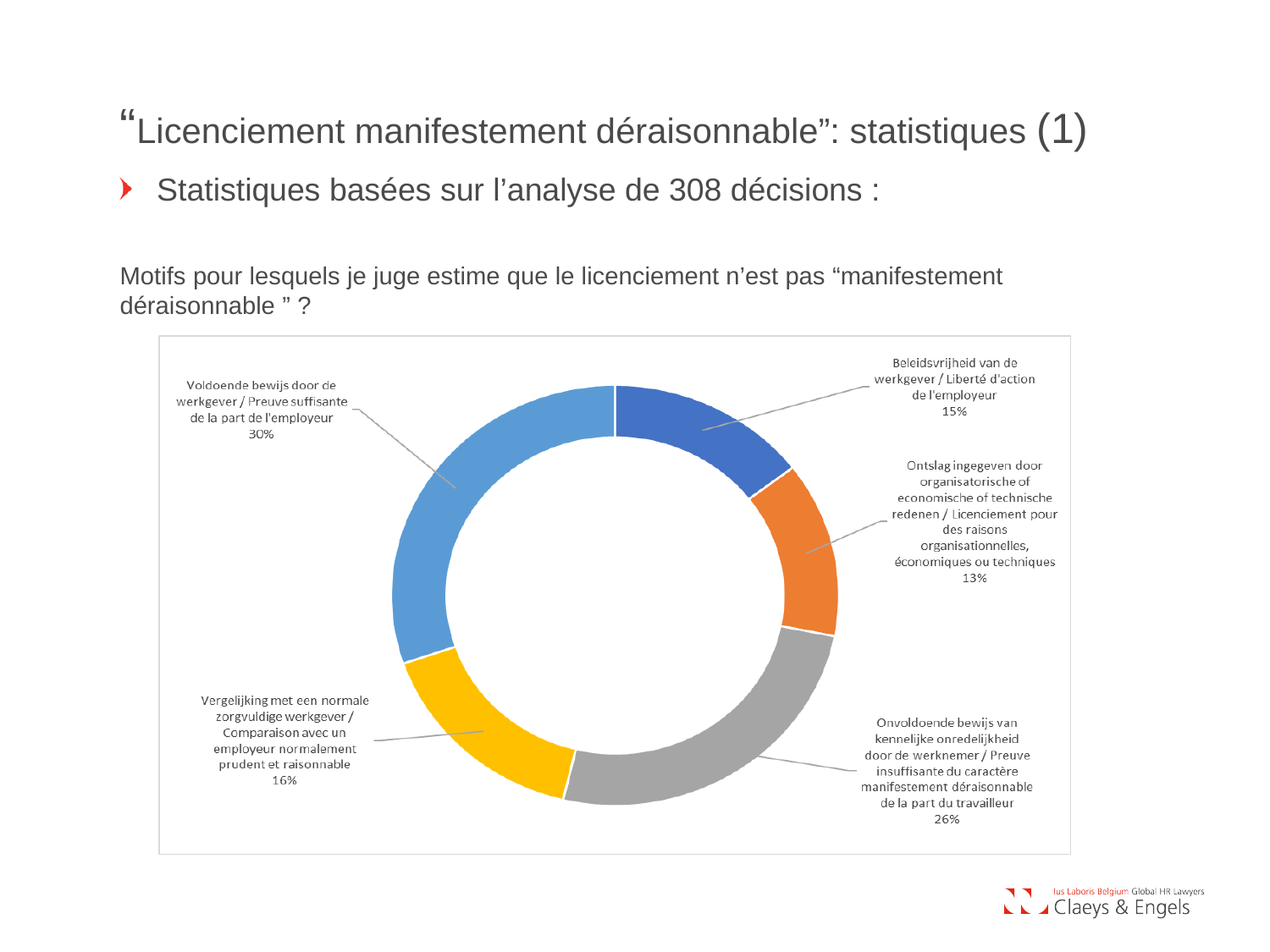
What percentage is shown for 'Onvoldoende bewijs van kennelijke onredelijkheid door de werknemer / Preuve insuffisante du caractère manifestement déraisonnable de la part du travailleur'? 26% What is the difference in percentage points between 'Voldoende bewijs door de werkgever' (30%) and 'Onvoldoende bewijs van kennelijke onredelijkheid door de werknemer' (26%)? 4 percentage points According to the slide, how many decisions were analysed for these statistics? 308 What percentage is shown for 'Vergelijking met een normale zorgvuldige werkgever / Comparaison avec un employeur normalement prudent et raisonnable'? 16% Which category has the largest share of the doughnut chart? Voldoende bewijs door de werkgever / Preuve suffisante de la part de l'employeur What percentage is shown for 'Ontslag ingegeven door organisatorische of economische of technische redenen / Licenciement pour des raisons organisationnelles, économiques ou techniques'? 13% What kind of chart is shown on the slide? Doughnut chart Which category has the smallest share of the doughnut chart? Ontslag ingegeven door organisatorische of economische of technische redenen / Licenciement pour des raisons organisationnelles, économiques ou techniques What share of the doughnut chart is 'Voldoende bewijs door de werkgever / Preuve suffisante de la part de l'employeur'? 30% Which is larger: the share for 'Vergelijking met een normale zorgvuldige werkgever' or the share for 'Beleidsvrijheid van de werkgever'? Vergelijking met een normale zorgvuldige werkgever What percentage is shown for 'Beleidsvrijheid van de werkgever / Liberté d'action de l'employeur'? 15% How many categories does the doughnut chart show? 5